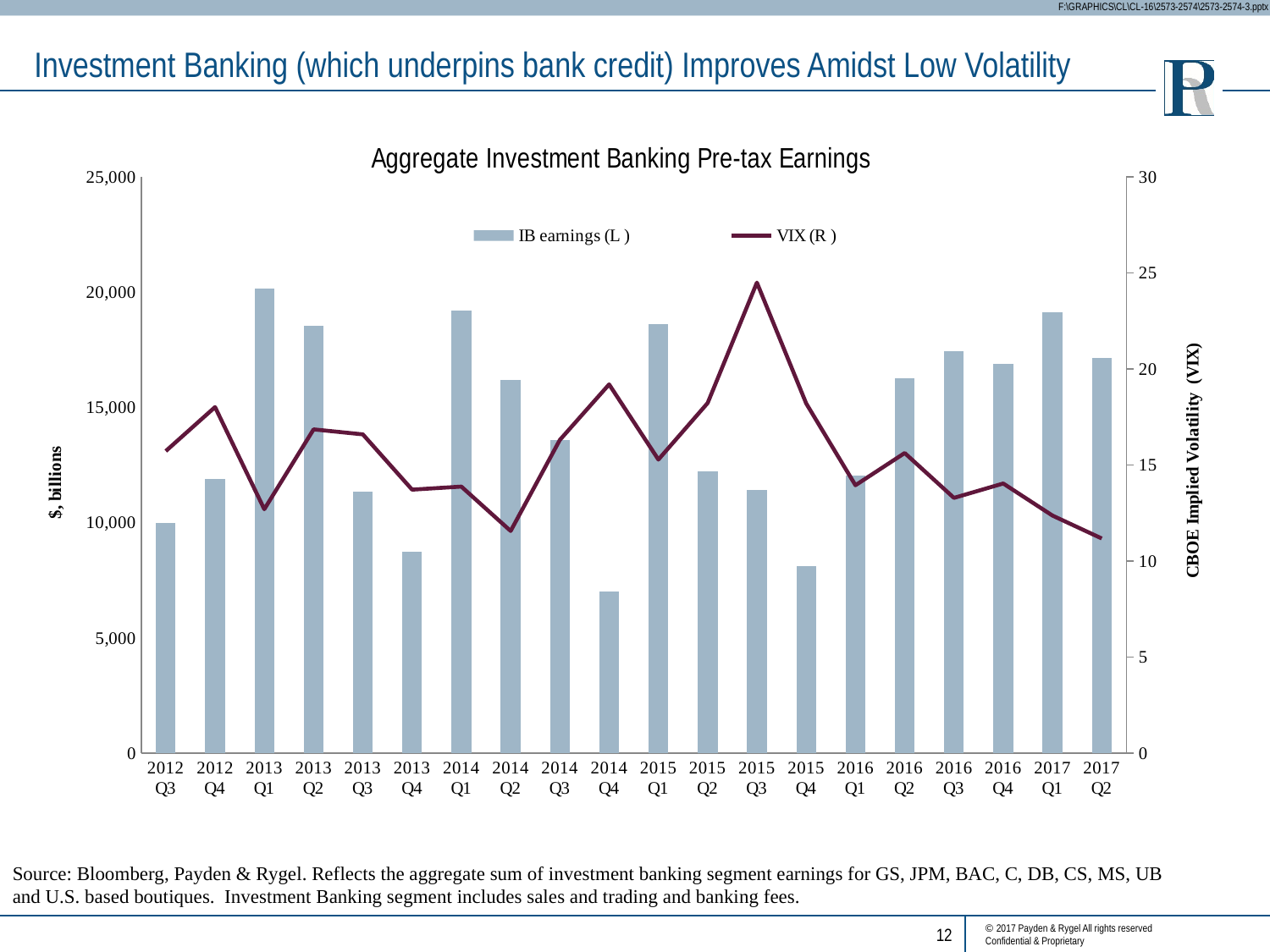
Is the VIX value for 2015 Q3 greater or less than 20? greater How many quarters are shown on the x axis? 20 What is the title of the chart? Aggregate Investment Banking Pre-tax Earnings How many series does the legend list? 2 Which quarter has the highest IB earnings bar? 2013 Q1 Is the IB earnings value for 2016 Q3 greater or less than 15,000? greater In which quarter does the VIX line reach its peak? 2015 Q3 Which quarter has the lowest IB earnings bar? 2014 Q4 What kind of chart is shown on the slide? A combined bar and line chart Which quarter has higher IB earnings, 2014 Q1 or 2014 Q4? 2014 Q1 Is the VIX value for 2017 Q2 greater or less than 15? less